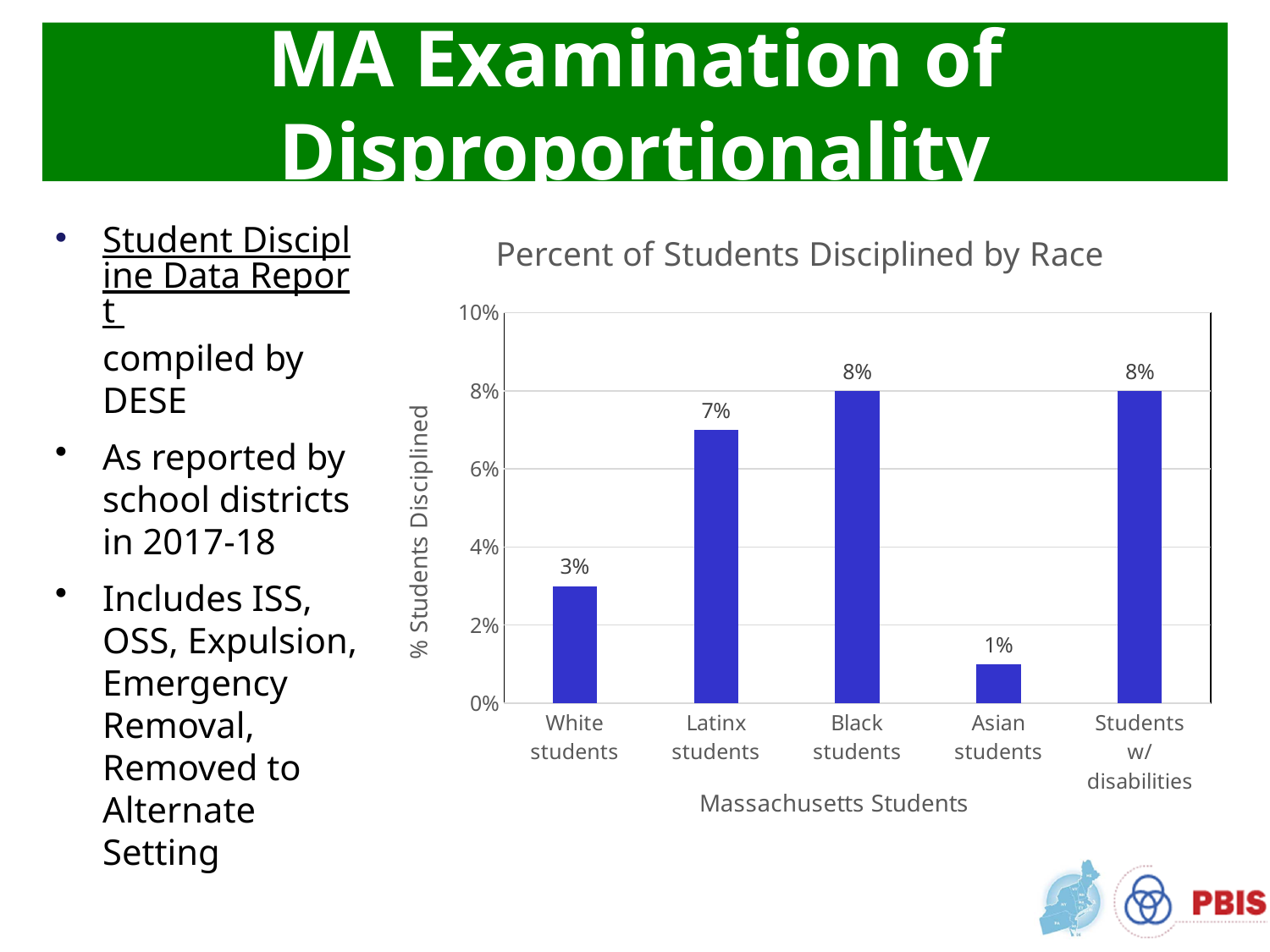
What percent of Asian students were disciplined? 1% Which group has a higher percent disciplined, Latinx students or White students? Latinx students What kind of chart is shown on the slide? Bar chart Is the value for Latinx students greater or less than 6%? greater What percent of Black students were disciplined? 8% Which category has the lowest percent of students disciplined? Asian students What percent of Latinx students were disciplined? 7% What is the difference in percent disciplined between Black students and White students? 5% What is the title of the chart? Percent of Students Disciplined by Race What percent of White students were disciplined? 3% How many student categories are shown on the x axis? 5 What percent of Students w/ disabilities were disciplined? 8%